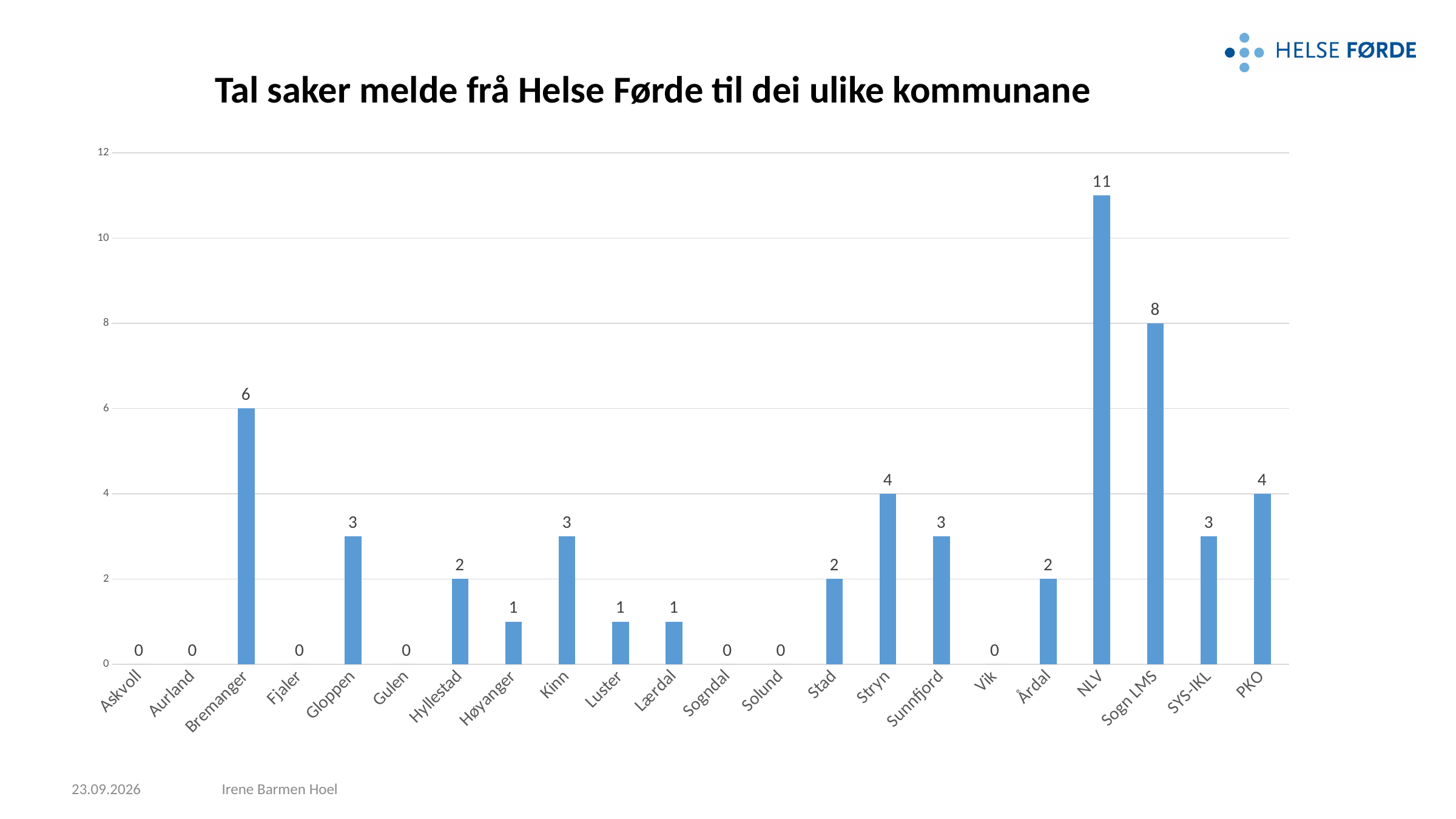
What kind of chart is shown on the slide? Bar chart What is the difference between the values for Bremanger and Gloppen? 3 What is the title of the chart? Tal saker melde frå Helse Førde til dei ulike kommunane Which is larger, the value for Stryn or the value for Sunnfjord? Stryn Which category has the highest value? NLV What is the difference between the values for NLV and Sogn LMS? 3 What is the value for Stryn? 4 Is the value for NLV greater or less than 10? greater How many categories are shown on the x axis? 22 What is the value for NLV? 11 What is the value for Sogn LMS? 8 What is the value for Bremanger? 6